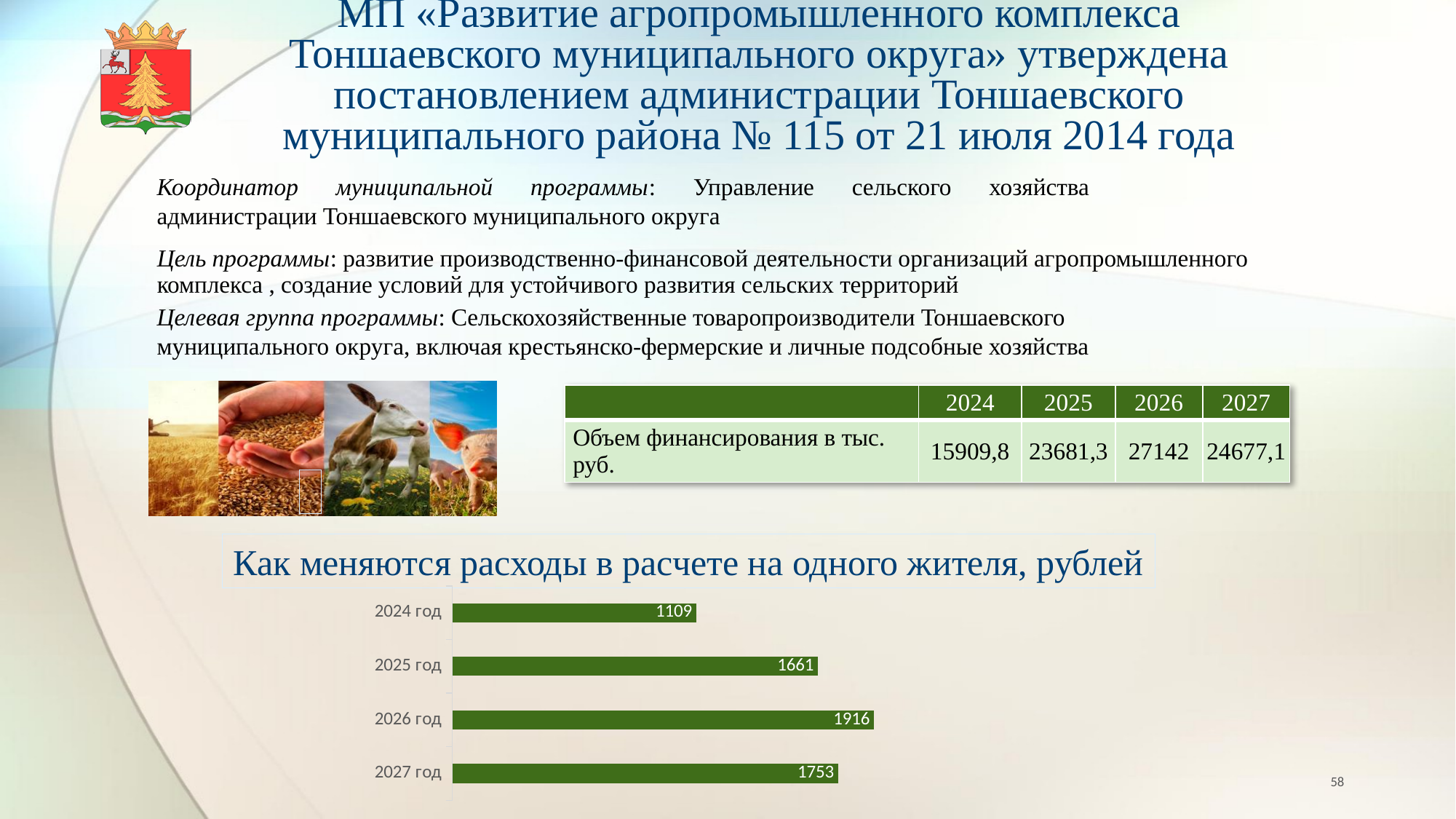
What is the value for 2027 год in the chart? 1753 What kind of chart is shown on the slide? Bar chart What is the title of the chart? Как меняются расходы в расчете на одного жителя, рублей What is the difference between the values for 2025 год and 2024 год? 552 Which is larger, the value for 2025 год or the value for 2027 год? 2027 год Which year has the highest value in the chart? 2026 год What is the value for 2025 год in the chart? 1661 What is the value for 2026 год in the chart? 1916 Which year has the lowest value in the chart? 2024 год What is the difference between the values for 2026 год and 2027 год? 163 What is the value for 2024 год in the chart? 1109 How many categories (years) are shown in the chart? 4